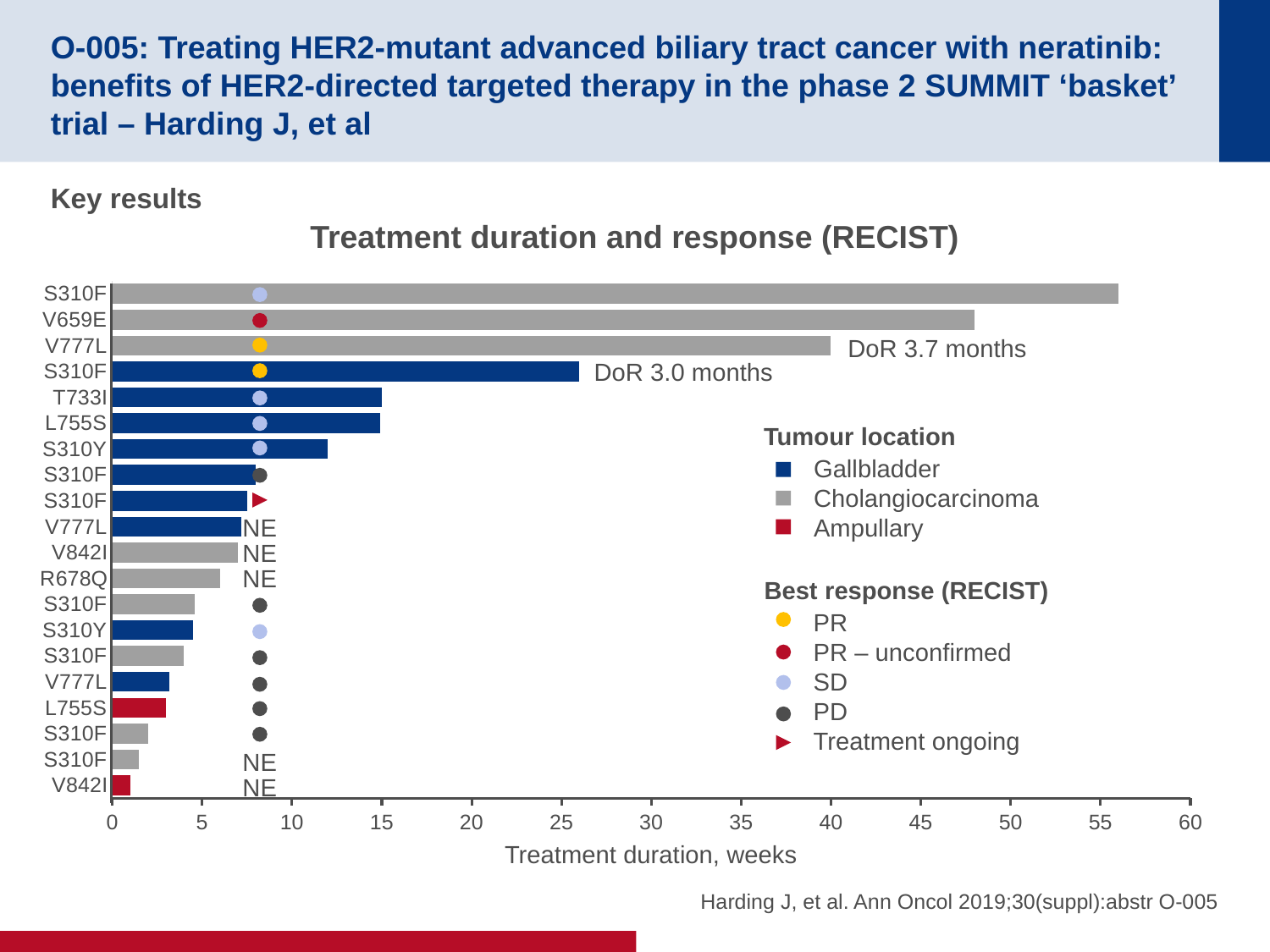
What duration of response is annotated next to the V777L bar near the top of the chart? DoR 3.7 months Which has the longer treatment duration, V659E or T733I? V659E What type of chart is shown on the slide? bar chart Which mutation label is on the bar with the longest treatment duration? S310F What is the title of the x axis? Treatment duration, weeks How many patient bars are plotted in the chart? 20 How many tumour locations are listed in the 'Tumour location' legend? 3 How many entries are listed under the 'Best response (RECIST)' legend? 5 Is the treatment duration for V659E greater or less than 45 weeks? greater Is the treatment duration for R678Q greater or less than 10 weeks? less Is the treatment duration for T733I greater or less than 20 weeks? less Which mutation label is on the bar with the shortest treatment duration? V842I